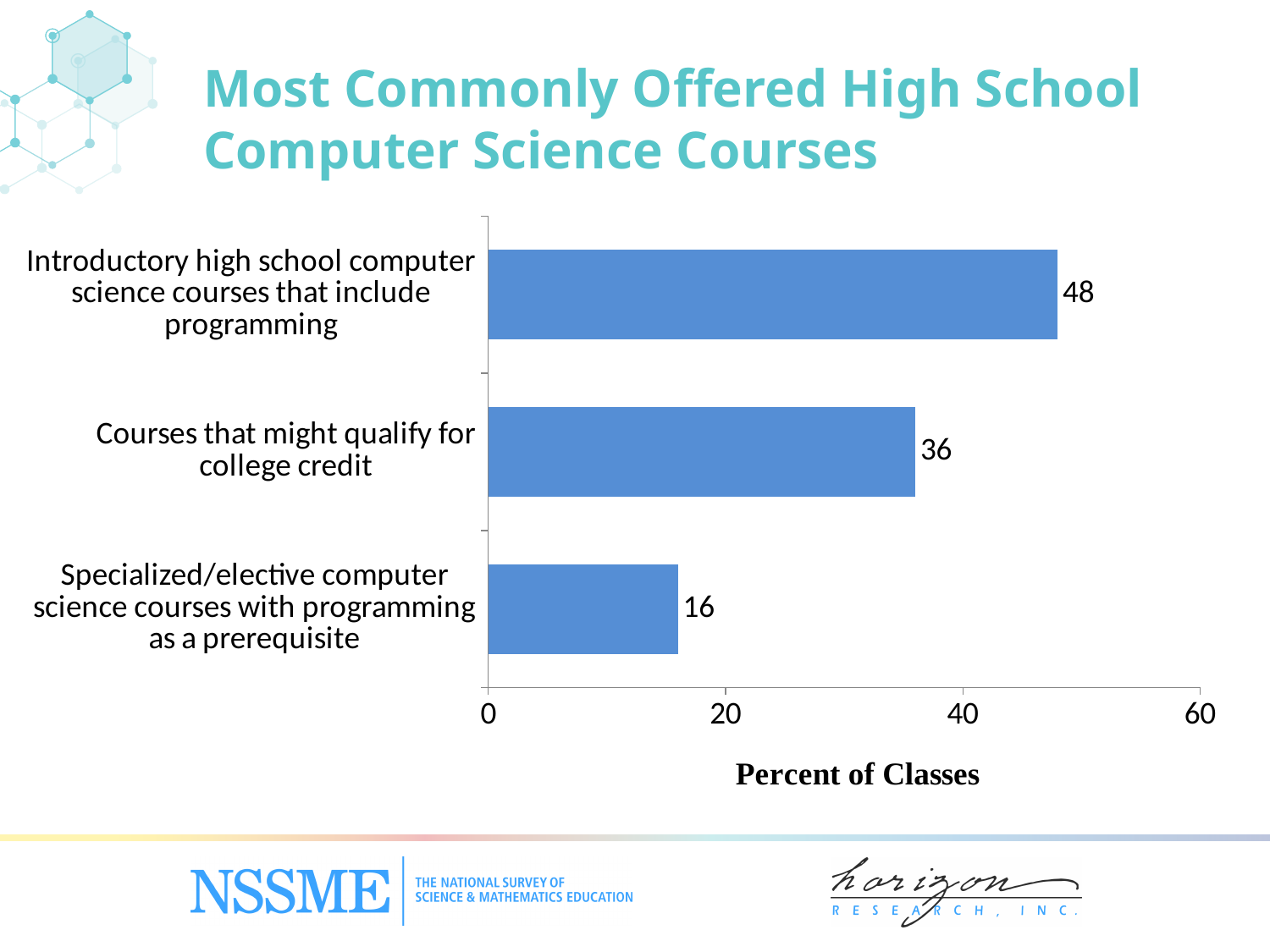
What is the value for introductory high school computer science courses that include programming? 48 Which category has the lowest percent of classes? Specialized/elective computer science courses with programming as a prerequisite What is the value for courses that might qualify for college credit? 36 What is the label of the horizontal axis? Percent of Classes Which category has the highest percent of classes? Introductory high school computer science courses that include programming How many categories are shown in the chart? 3 What kind of chart is shown on the slide? Bar chart What is the value for specialized/elective computer science courses with programming as a prerequisite? 16 Is the value for courses that might qualify for college credit greater or less than 40? less What is the difference between the values for courses that might qualify for college credit and specialized/elective courses with programming as a prerequisite? 20 What is the difference between the values for introductory courses that include programming and courses that might qualify for college credit? 12 Which is larger: the value for courses that might qualify for college credit or for specialized/elective courses with programming as a prerequisite? Courses that might qualify for college credit